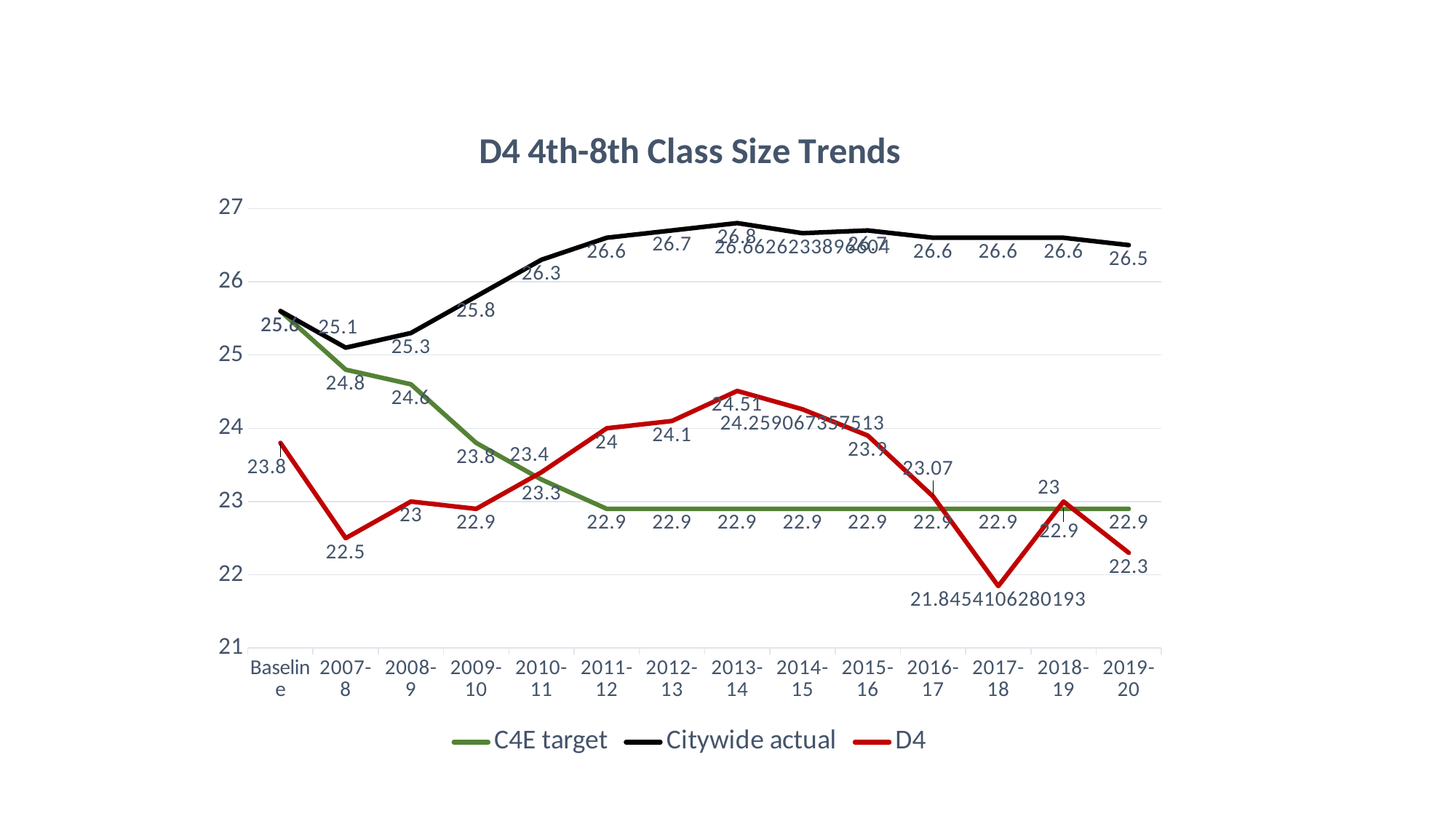
In which year is the D4 value lowest? 2017-18 What is the D4 value for 2007-8? 22.5 What is the difference between the Citywide actual and D4 values in 2019-20? 4.2 What kind of chart is shown on the slide? line chart How many series does the legend list? 3 What is the C4E target value for 2009-10? 23.8 In which year is the Citywide actual value highest? 2013-14 What is the Citywide actual value for 2012-13? 26.7 What is the D4 value for 2019-20? 22.3 How many categories are shown on the x axis? 14 Does the C4E target rise or fall from Baseline to 2011-12? fall In 2013-14, which is larger: the D4 value or the C4E target value? D4